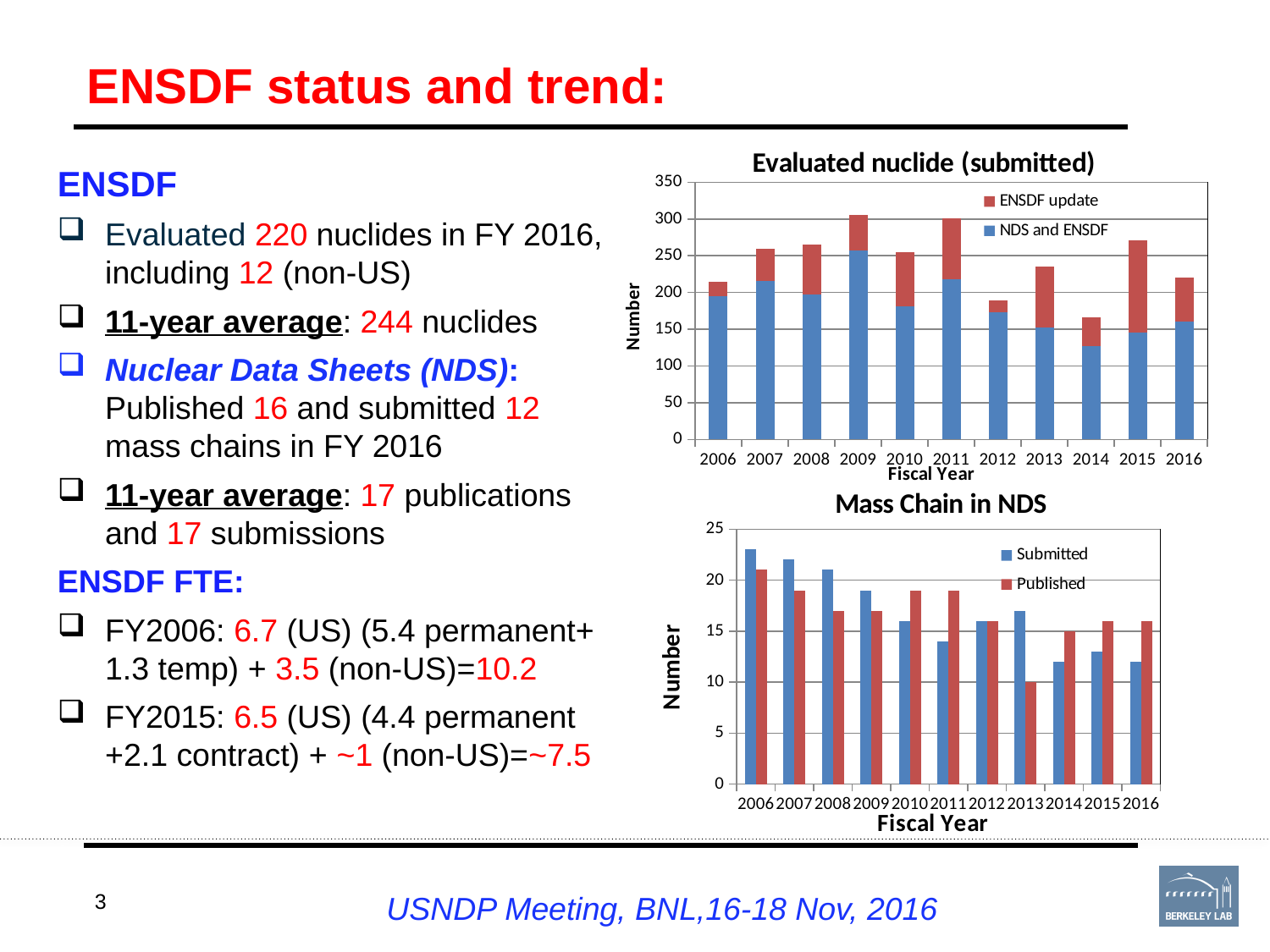
In the 'Evaluated nuclide (submitted)' chart, is the total bar for 2009 greater or less than 250? greater In the 'Evaluated nuclide (submitted)' chart, which has the larger total bar, 2015 or 2014? 2015 In the 'Evaluated nuclide (submitted)' chart, what are the two legend entries? ENSDF update; NDS and ENSDF In the 'Mass Chain in NDS' chart, is the Submitted value for 2006 greater or less than 20? greater In the 'Evaluated nuclide (submitted)' chart, is the total bar for 2014 greater or less than 200? less In the 'Evaluated nuclide (submitted)' chart, what kind of chart is used? Stacked bar chart In the 'Evaluated nuclide (submitted)' chart, how many fiscal years are shown on the x axis? 11 In the 'Mass Chain in NDS' chart, which fiscal year has the highest Submitted bar? 2006 In the 'Mass Chain in NDS' chart, how many series does the legend list? 2 In the 'Evaluated nuclide (submitted)' chart, which fiscal year has the lowest total bar? 2014 In the 'Mass Chain in NDS' chart, which fiscal year has the lowest Published bar? 2013 In the 'Evaluated nuclide (submitted)' chart, how many series does the legend list? 2